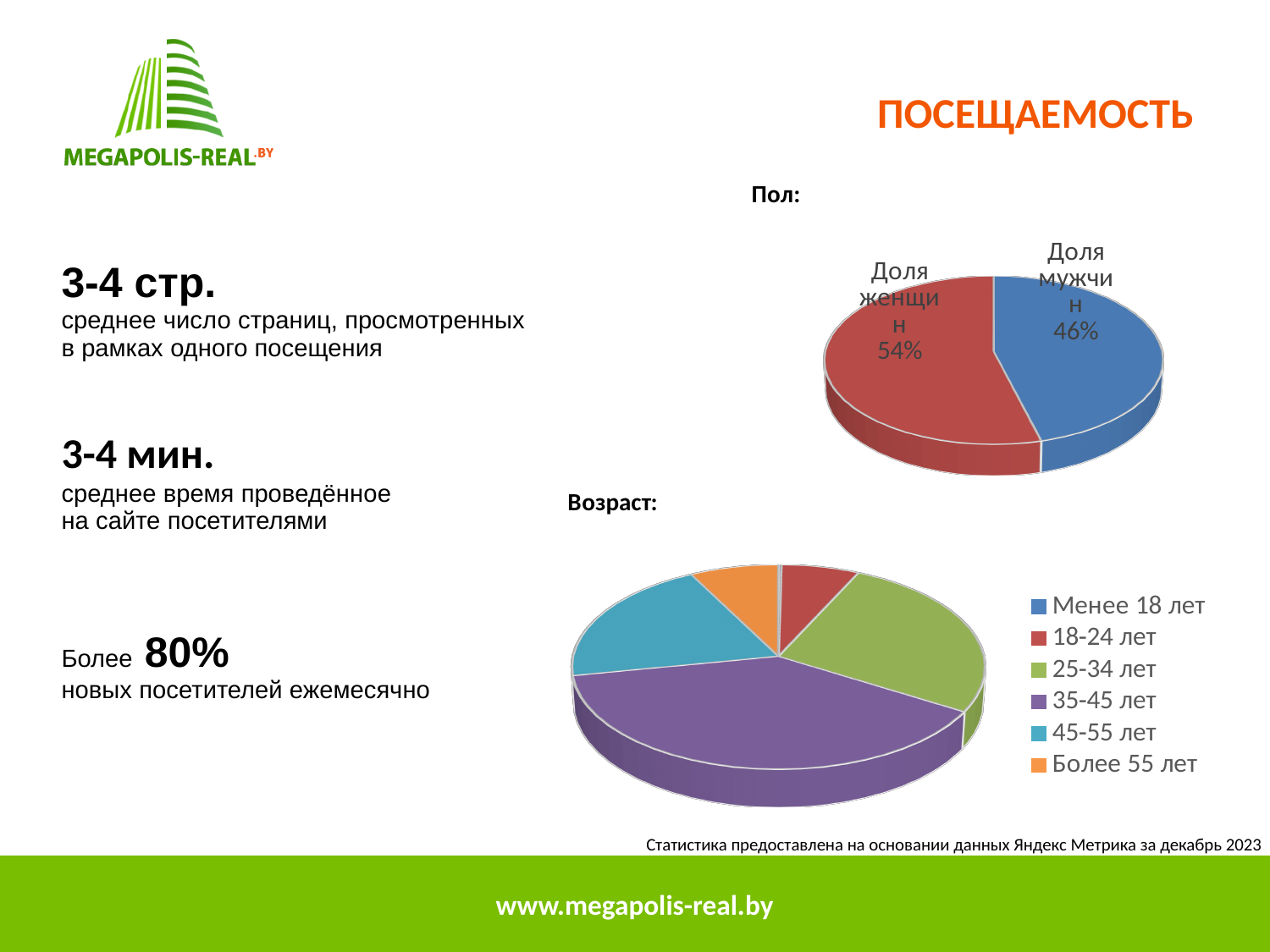
In the 'Пол:' pie chart, what share is shown for 'Доля мужчин'? 46% In the 'Возраст:' pie chart, what colour represents the '35-45 лет' category? Purple What type of chart is the 'Пол:' chart? Pie chart In the 'Возраст:' pie chart, which age group has the largest slice? 35-45 лет In the 'Пол:' pie chart, which slice is the largest? Доля женщин In the 'Возраст:' pie chart, which slice is larger: '35-45 лет' or '45-55 лет'? 35-45 лет In the 'Пол:' pie chart, what is the difference in percentage points between 'Доля женщин' and 'Доля мужчин'? 8 In the 'Пол:' pie chart, what share is shown for 'Доля женщин'? 54% How many categories does the legend of the 'Возраст:' chart list? 6 In the 'Пол:' pie chart, which is larger: 'Доля женщин' or 'Доля мужчин'? Доля женщин In the 'Пол:' pie chart, which slice is the smallest? Доля мужчин How many slices does the 'Пол:' pie chart have? 2